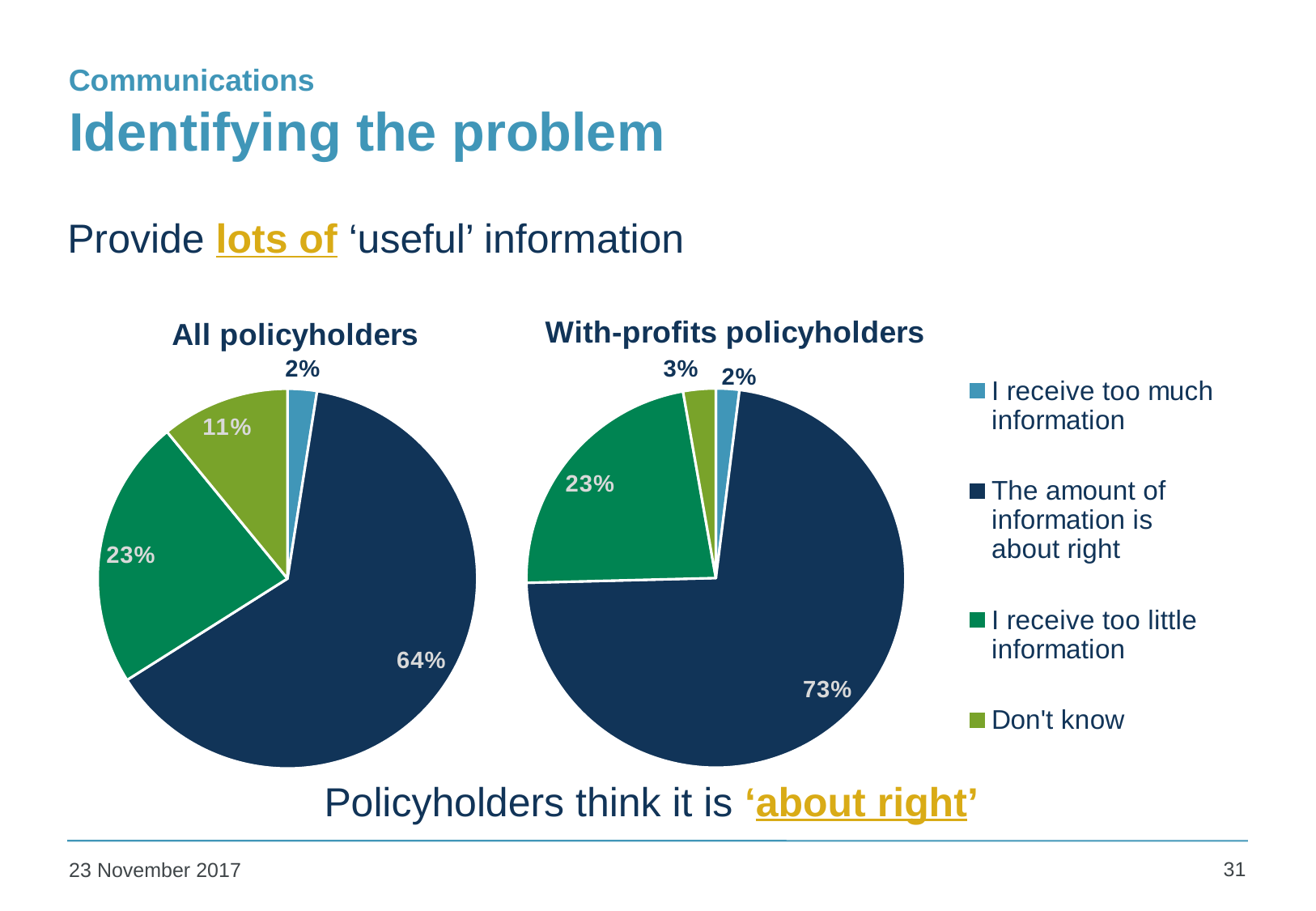
In the 'With-profits policyholders' chart, what share of respondents answered 'Don't know'? 3% How many categories does the legend list? 4 What type of chart is used on this slide? Pie chart In the 'With-profits policyholders' chart, what share of respondents say the amount of information is about right? 73% In the 'With-profits policyholders' chart, which category has the largest slice? The amount of information is about right Which chart shows a larger share for 'The amount of information is about right', 'All policyholders' or 'With-profits policyholders'? With-profits policyholders In the 'All policyholders' chart, which category has the smallest slice? I receive too much information What is the difference between the 'about right' share in the 'With-profits policyholders' chart and in the 'All policyholders' chart? 9 percentage points In the 'All policyholders' chart, what share of respondents answered 'Don't know'? 11% In the 'All policyholders' chart, what share of respondents say the amount of information is about right? 64% In the 'All policyholders' chart, what share of respondents say they receive too little information? 23% In the 'All policyholders' chart, what is the difference between the 'I receive too little information' share and the 'Don't know' share? 12 percentage points